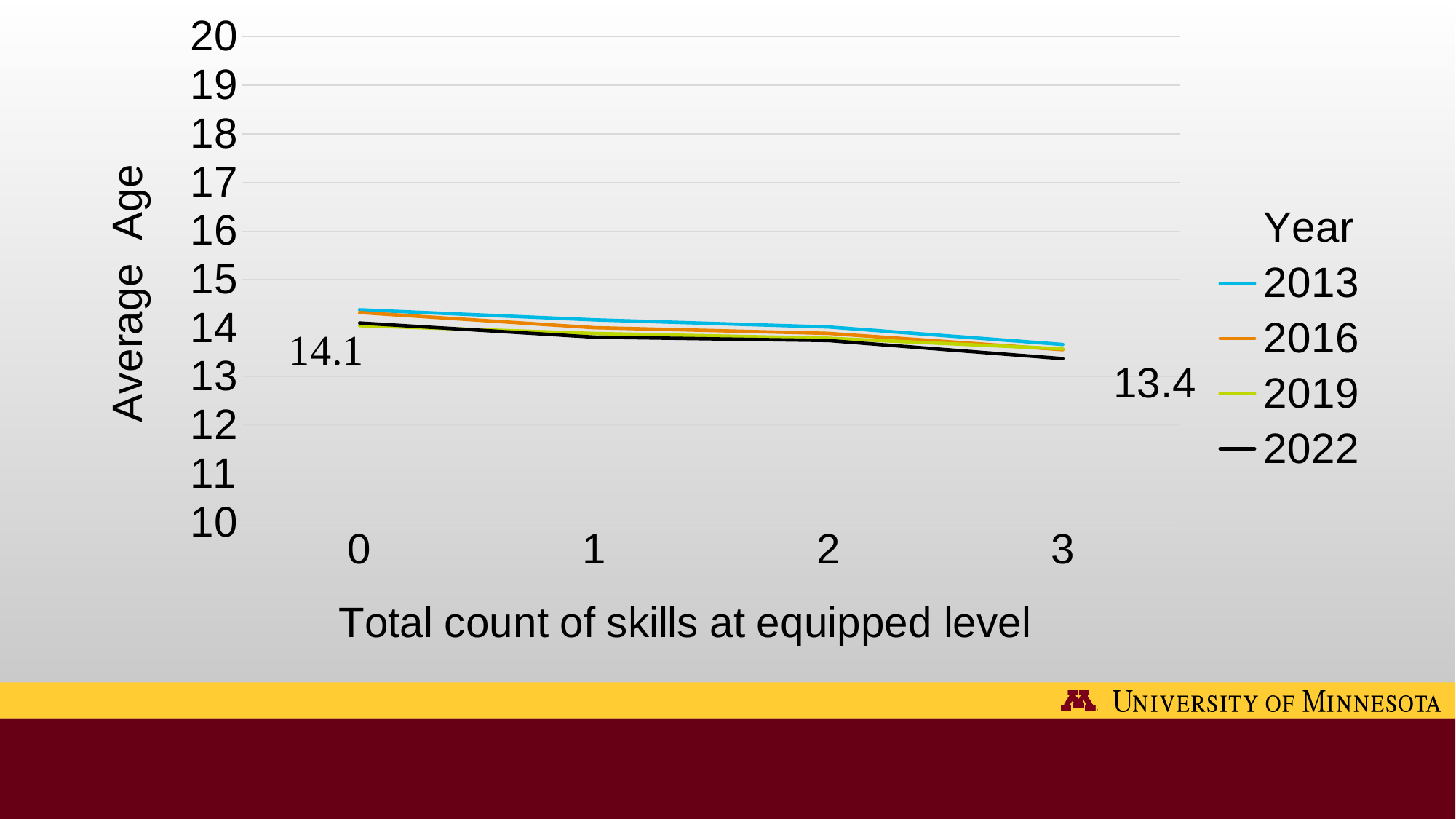
What is the difference between the 2022 series value at 0 skills and at 3 skills? 0.7 How many series does the legend list? 4 Which series has the highest average age at a total count of 3 skills? 2013 Which series has the lowest average age at a total count of 3 skills? 2022 Is the value for the 2013 series at 0 skills greater or less than 15? less How many points are plotted along the x axis for each series? 4 What is the average age for the 2022 series at a total count of 0 skills at equipped level? 14.1 Do the average age values rise or fall as the total count of skills at equipped level increases? fall Is the value for the 2013 series at 3 skills greater or less than 13? greater What is the average age for the 2022 series at a total count of 3 skills at equipped level? 13.4 What kind of chart is shown on the slide? line chart What is the title of the y axis? Average Age